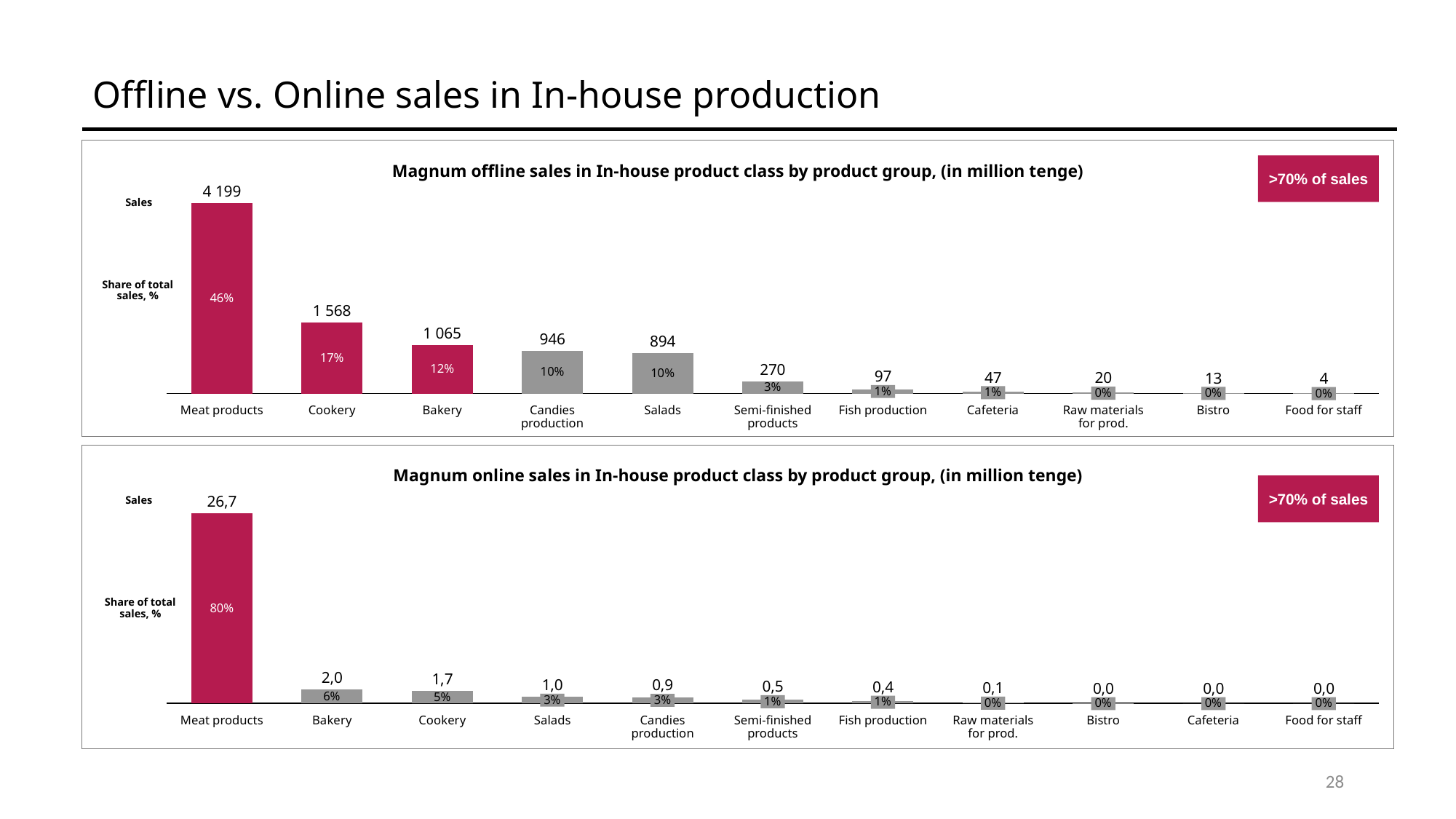
What type of chart is the online sales chart? Bar chart In the offline sales chart, which has higher sales, Candies production or Salads? Candies production How many product groups are shown in the offline sales chart? 11 In the offline sales chart, what share of total sales does Cookery have? 17% In the offline sales chart, what is the difference in sales between Cookery and Bakery? 503 In the offline sales chart, which product group has the lowest sales? Food for staff In the online sales chart, what share of total sales does Bakery have? 6% In the online sales chart, what is the sales value for Meat products? 26,7 In the online sales chart, what is the difference in sales between Bakery and Cookery? 0,3 What is the title of the top chart? Magnum offline sales in In-house product class by product group, (in million tenge) In the offline sales chart, what is the sales value for Meat products? 4 199 In the online sales chart, which product group has the highest sales? Meat products